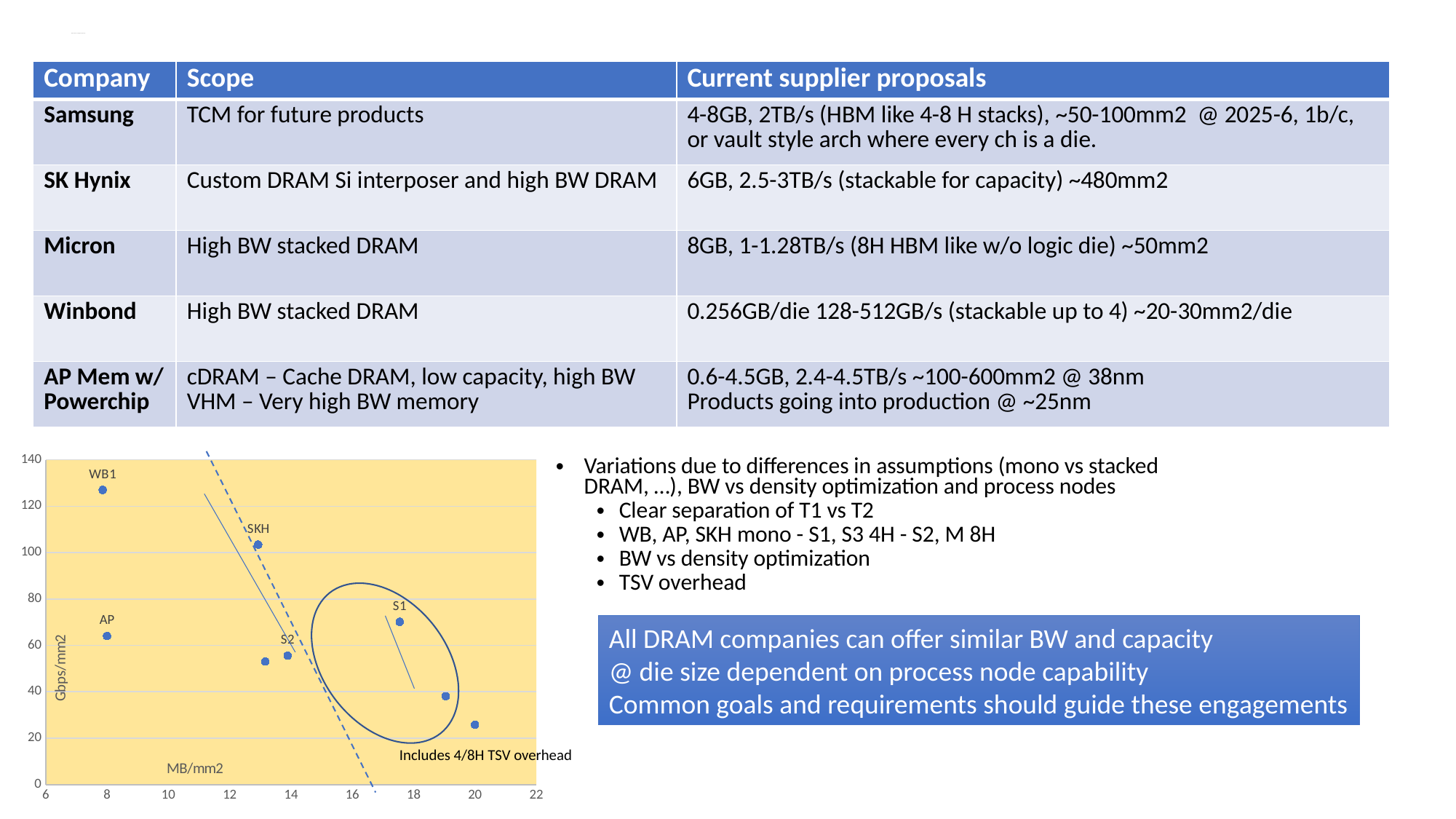
Which labelled point has the highest Gbps/mm2 value in the scatter chart? WB1 In the scatter chart, which has the higher Gbps/mm2 value, WB1 or SKH? WB1 In the scatter chart, is the Gbps/mm2 value for AP greater or less than 80? less In the scatter chart, is the Gbps/mm2 value for SKH greater or less than 80? greater What is the label on the vertical axis of the scatter chart? Gbps/mm2 In the scatter chart, which has the higher Gbps/mm2 value, AP or SKH? SKH In the scatter chart, is the Gbps/mm2 value for WB1 greater or less than 120? greater What is the label on the horizontal axis of the scatter chart? MB/mm2 What kind of chart is shown at the bottom left of the slide? scatter chart